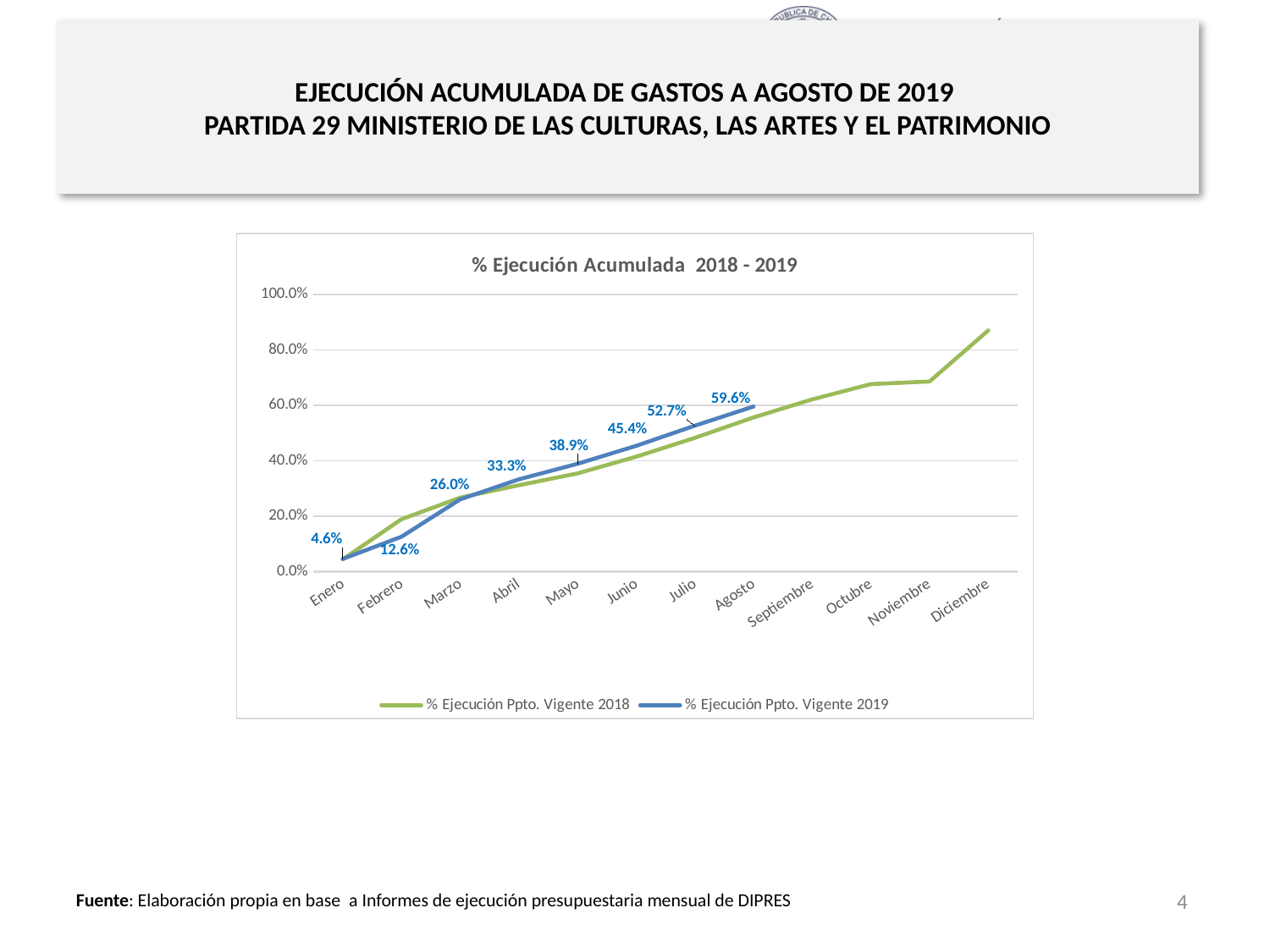
What is the difference between the Agosto and Julio values in the % Ejecución Ppto. Vigente 2019 series? 6.9% Do the values of the % Ejecución Ppto. Vigente 2019 series rise or fall from Enero to Agosto? Rise What kind of chart is shown on the slide? Line chart What is the difference between the Marzo and Febrero values in the % Ejecución Ppto. Vigente 2019 series? 13.4% What is the value for Marzo in the % Ejecución Ppto. Vigente 2019 series? 26.0% Is the value for Diciembre in the % Ejecución Ppto. Vigente 2018 series greater or less than 80.0%? greater How many series does the legend list? 2 What is the value for Enero in the % Ejecución Ppto. Vigente 2019 series? 4.6% Which month has the highest labelled value in the % Ejecución Ppto. Vigente 2019 series? Agosto What is the value for Mayo in the % Ejecución Ppto. Vigente 2019 series? 38.9% How many months are shown on the x axis? 12 What is the value for Agosto in the % Ejecución Ppto. Vigente 2019 series? 59.6%